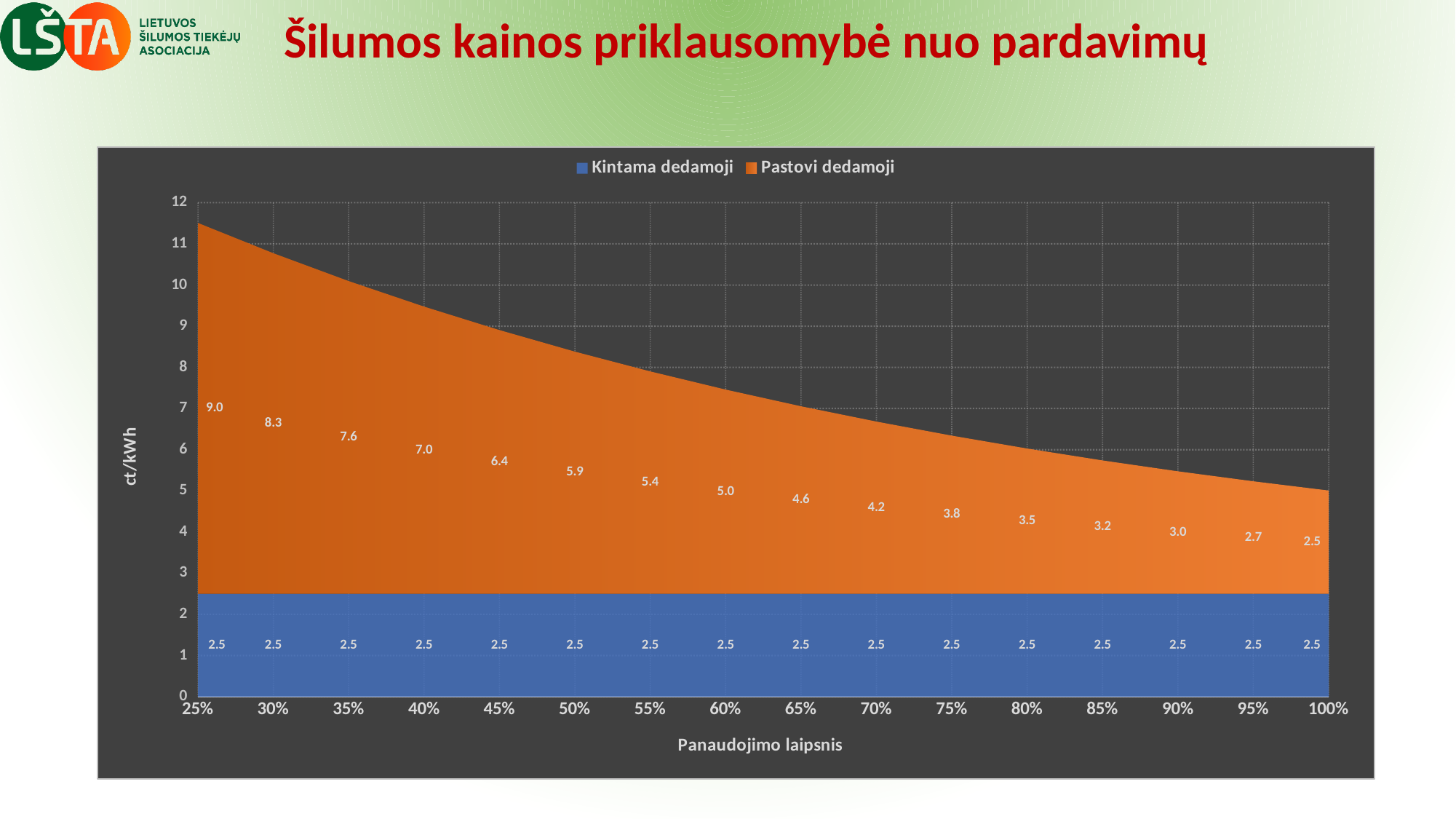
What is the value of Kintama dedamoji at 50%? 2.5 What is the total stacked value (Kintama dedamoji plus Pastovi dedamoji) at 25%? 11.5 At which Panaudojimo laipsnis value is Pastovi dedamoji lowest? 100% At which Panaudojimo laipsnis value is Pastovi dedamoji highest? 25% What is the value of Pastovi dedamoji at 60%? 5.0 What is the value of Pastovi dedamoji at 25%? 9.0 Does Pastovi dedamoji rise or fall as Panaudojimo laipsnis increases? Fall How many series does the legend list? 2 What is the difference between Pastovi dedamoji at 25% and at 100%? 6.5 Which is larger: Pastovi dedamoji at 40% or at 70%? 40% What kind of chart is shown? Stacked area chart How many Panaudojimo laipsnis categories are shown on the x axis? 16